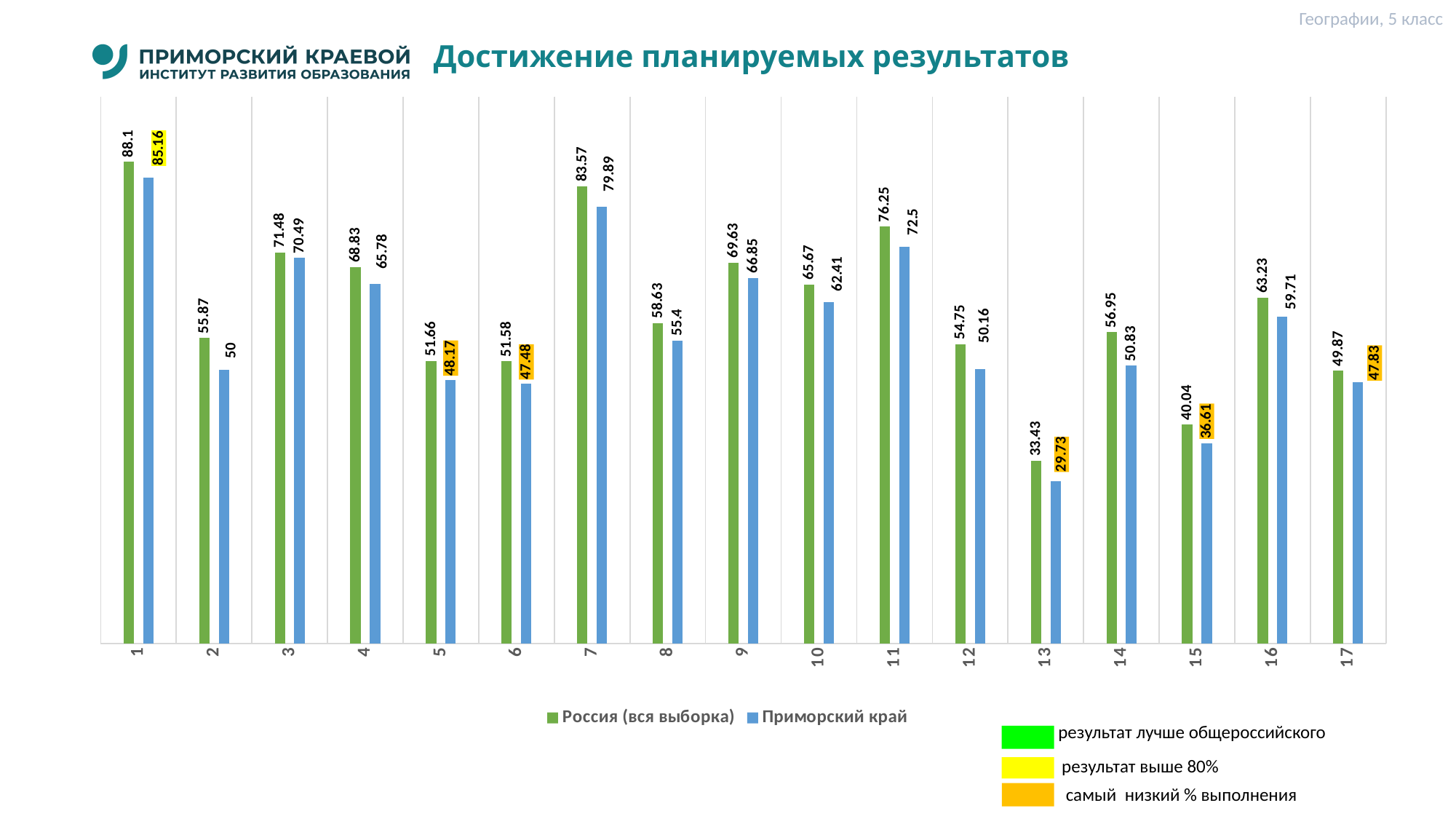
Which category has the lowest value for Приморский край? 13 Which is larger for category 11: the value for Россия (вся выборка) or for Приморский край? Россия (вся выборка) How many categories are shown on the x axis? 17 How many series does the chart legend list? 2 What is the value for Приморский край for category 7? 79.89 What is the difference between the Россия (вся выборка) and Приморский край values for category 2? 5.87 Which colour represents Приморский край in the chart? blue What kind of chart is shown on the slide? bar chart What is the value for Россия (вся выборка) for category 13? 33.43 What is the value for Приморский край for category 1? 85.16 Which category has the highest value for Россия (вся выборка)? 1 What is the difference between the Россия (вся выборка) and Приморский край values for category 1? 2.94